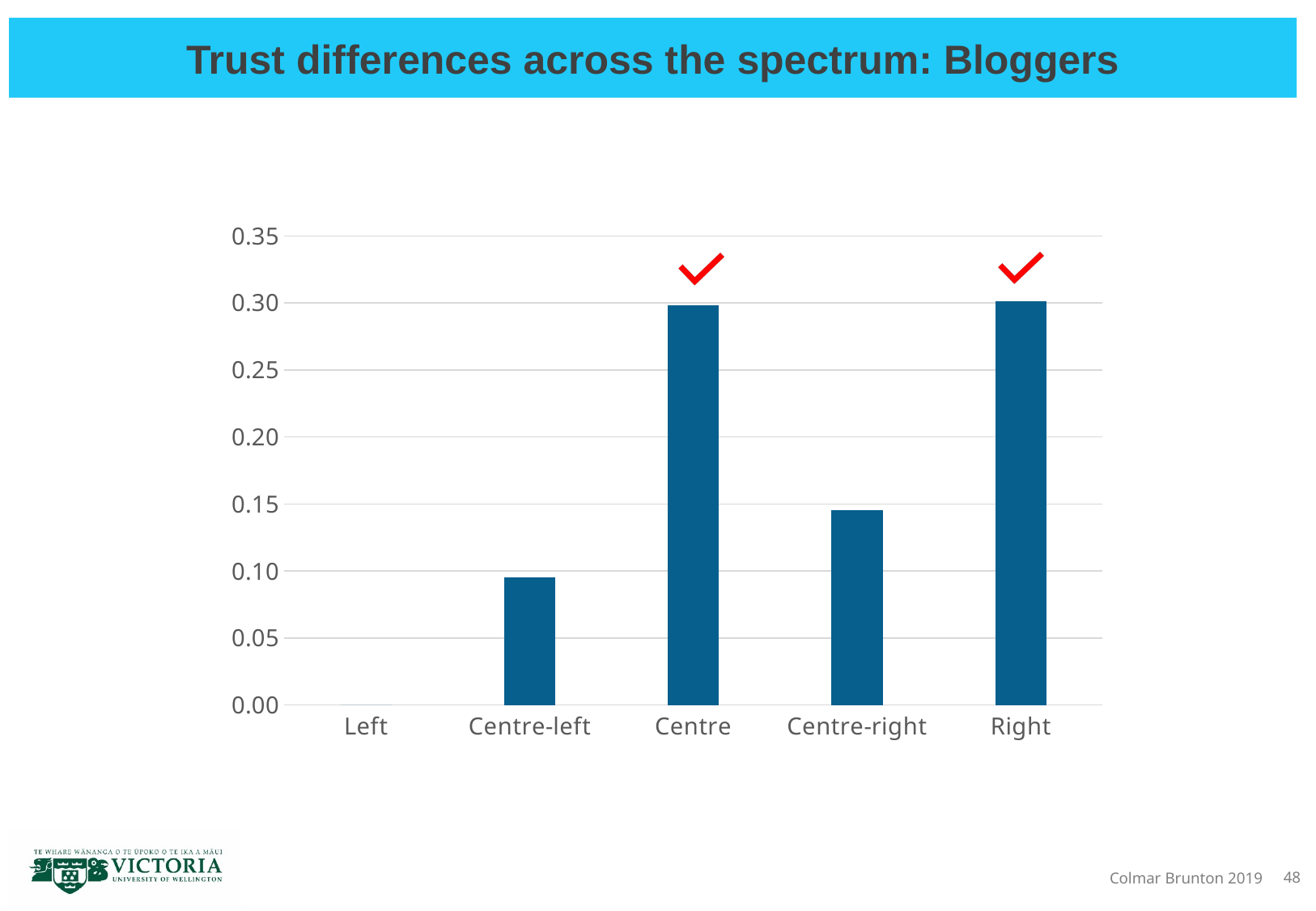
Which categories have a red check mark above their bars? Centre and Right Is the value for Centre greater or less than 0.25? greater Is the value for Centre-right greater or less than 0.10? greater What is the title of the slide containing the chart? Trust differences across the spectrum: Bloggers Which has a larger value, Centre or Centre-right? Centre Is the value for Left greater or less than 0.05? less Which has a larger value, Centre-left or Centre-right? Centre-right What kind of chart is shown on the slide? bar chart Which category has the lowest value in the chart? Left How many categories are shown on the x axis of the chart? 5